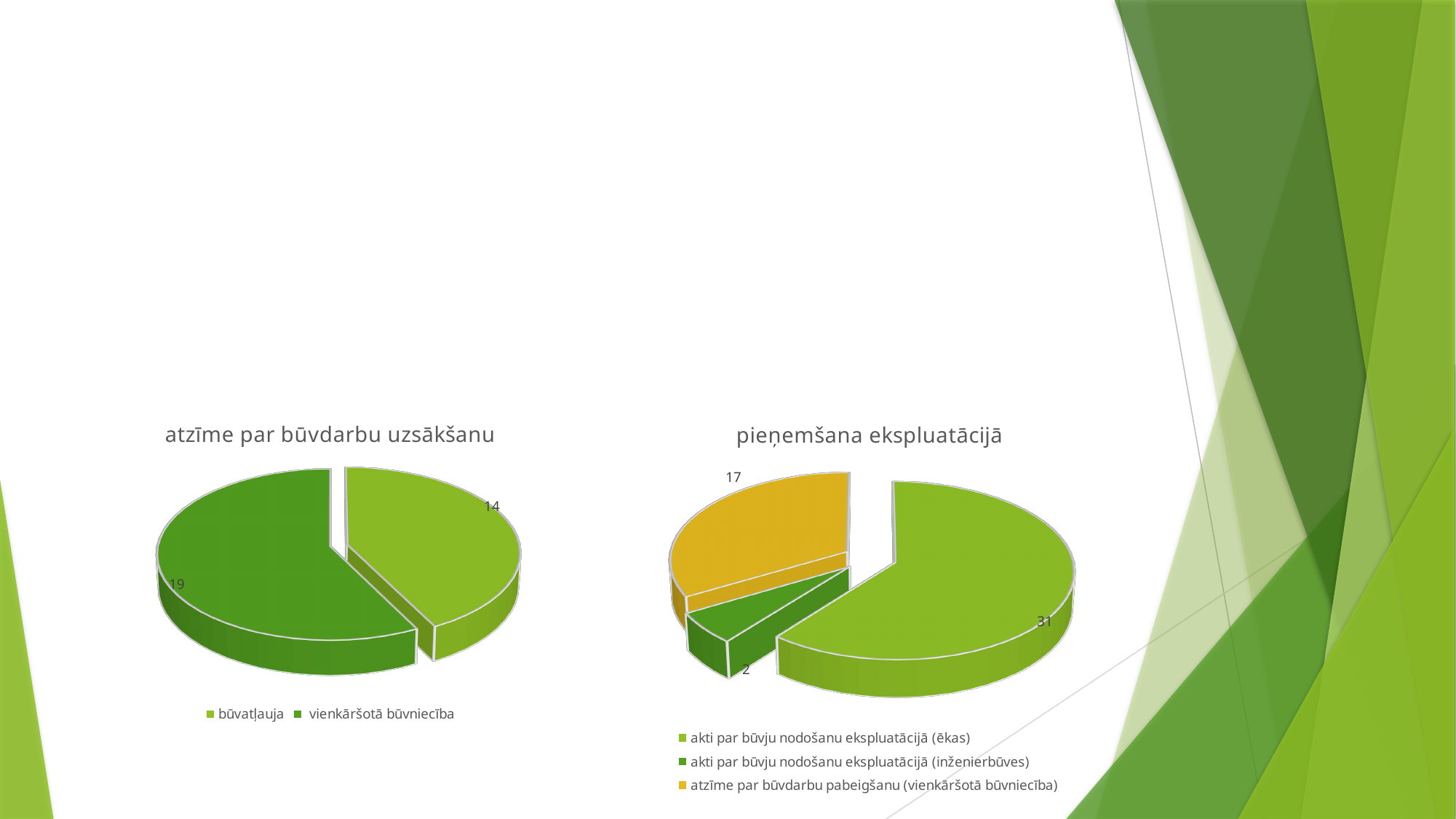
In the chart titled "pieņemšana ekspluatācijā", which category has the smallest value? akti par būvju nodošanu ekspluatācijā (inženierbūves) In the chart titled "pieņemšana ekspluatācijā", what is the value for akti par būvju nodošanu ekspluatācijā (ēkas)? 31 In the chart titled "atzīme par būvdarbu uzsākšanu", which category has the larger value? vienkāršotā būvniecība In the chart titled "pieņemšana ekspluatācijā", what is the difference between the ēkas slice and the vienkāršotā būvniecība slice? 14 What type of chart is the chart titled "atzīme par būvdarbu uzsākšanu"? pie chart In the chart titled "atzīme par būvdarbu uzsākšanu", what is the value for būvatļauja? 14 How many categories does the chart titled "pieņemšana ekspluatācijā" show? 3 In the chart titled "pieņemšana ekspluatācijā", what is the value for akti par būvju nodošanu ekspluatācijā (inženierbūves)? 2 In the chart titled "atzīme par būvdarbu uzsākšanu", what is the value for vienkāršotā būvniecība? 19 In the chart titled "pieņemšana ekspluatācijā", what is the value for atzīme par būvdarbu pabeigšanu (vienkāršotā būvniecība)? 17 In the chart titled "atzīme par būvdarbu uzsākšanu", what is the difference between vienkāršotā būvniecība and būvatļauja? 5